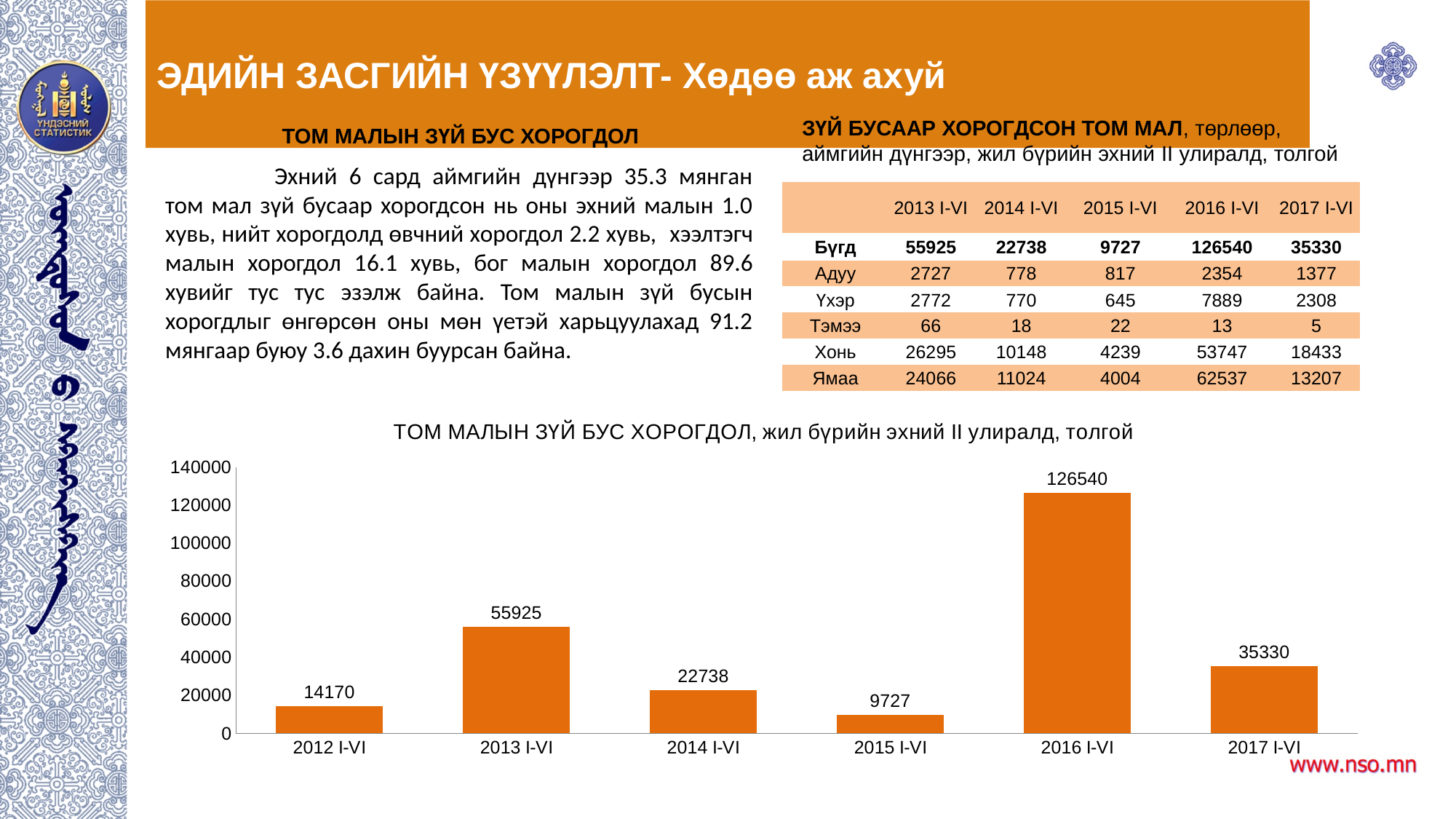
How many periods are shown on the x axis of the bar chart? 6 What is the difference between the values for 2016 I-VI and 2017 I-VI in the bar chart? 91210 Does the value fall or rise from 2013 I-VI to 2015 I-VI in the bar chart? fall What is the value for 2012 I-VI in the bar chart? 14170 Which is larger in the bar chart, the value for 2013 I-VI or the value for 2017 I-VI? 2013 I-VI Which period has the lowest value in the bar chart? 2015 I-VI What is the difference between the values for 2013 I-VI and 2014 I-VI in the bar chart? 33187 Is the value for 2014 I-VI in the bar chart greater or less than 40000? less What is the value for 2016 I-VI in the bar chart? 126540 Which period has the highest value in the bar chart? 2016 I-VI What is the value for 2017 I-VI in the bar chart? 35330 What kind of chart is shown on the slide? bar chart